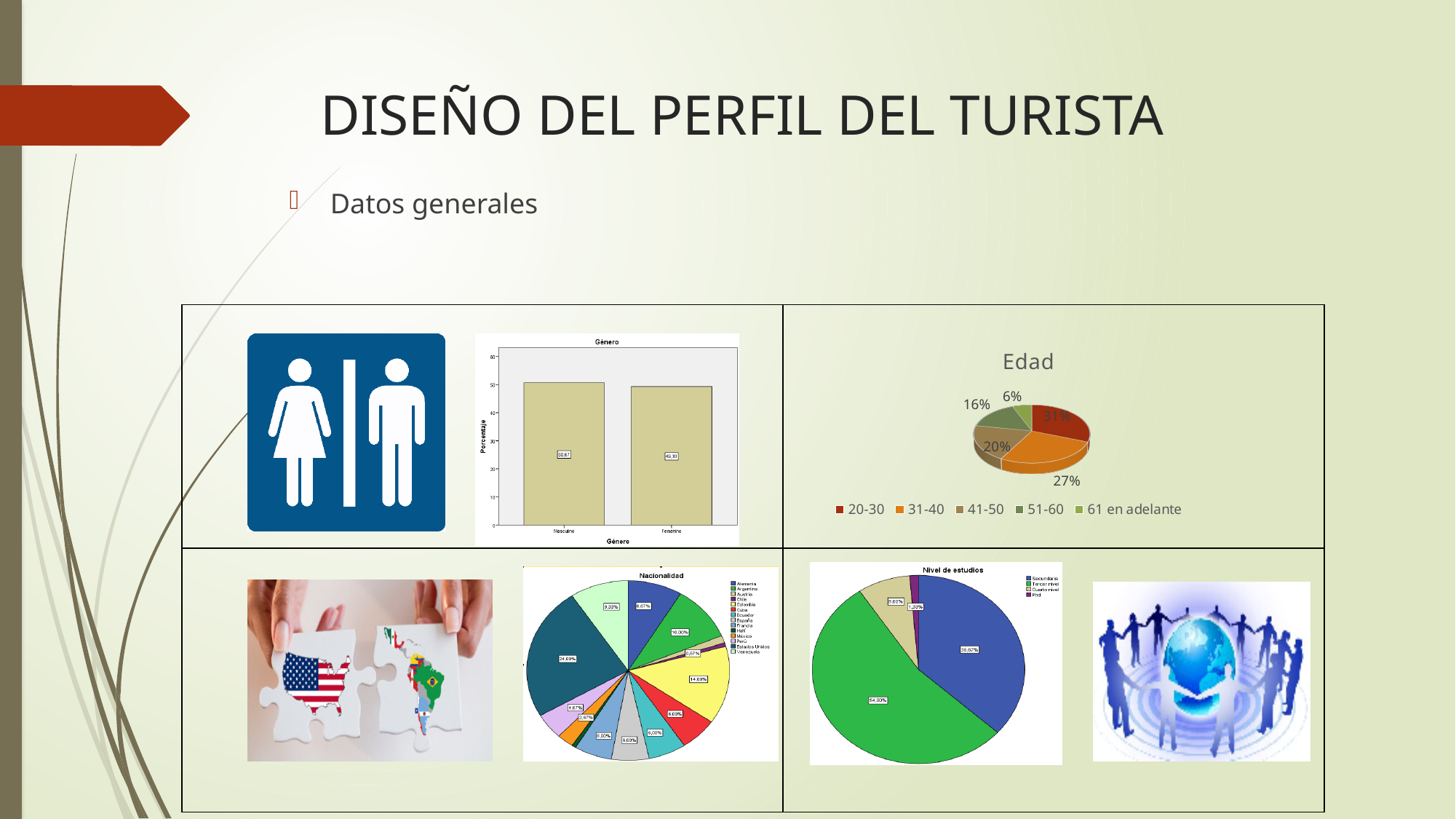
In the Edad chart, which age group has the smallest share? 61 en adelante How many categories does the legend of the Edad chart list? 5 In the Edad chart, which age group has the largest share? 20-30 In the Nivel de estudios chart, which category has the smallest share? Phd What kind of chart is the Género chart? bar chart In the Nivel de estudios chart, what share does Tercer nivel have? 54,00% In the Edad chart, what share does the 20-30 group have? 31% In the Edad chart, what is the difference between the 20-30 share and the 31-40 share? 4% In the Nivel de estudios chart, what is the difference between the Tercer nivel share and the Secundaria share? 17,33% In the Género chart, what is the value for Femenino? 49,33 In the Género chart, what is the value for Masculino? 50,67 In the Género chart, which category has the higher value, Masculino or Femenino? Masculino